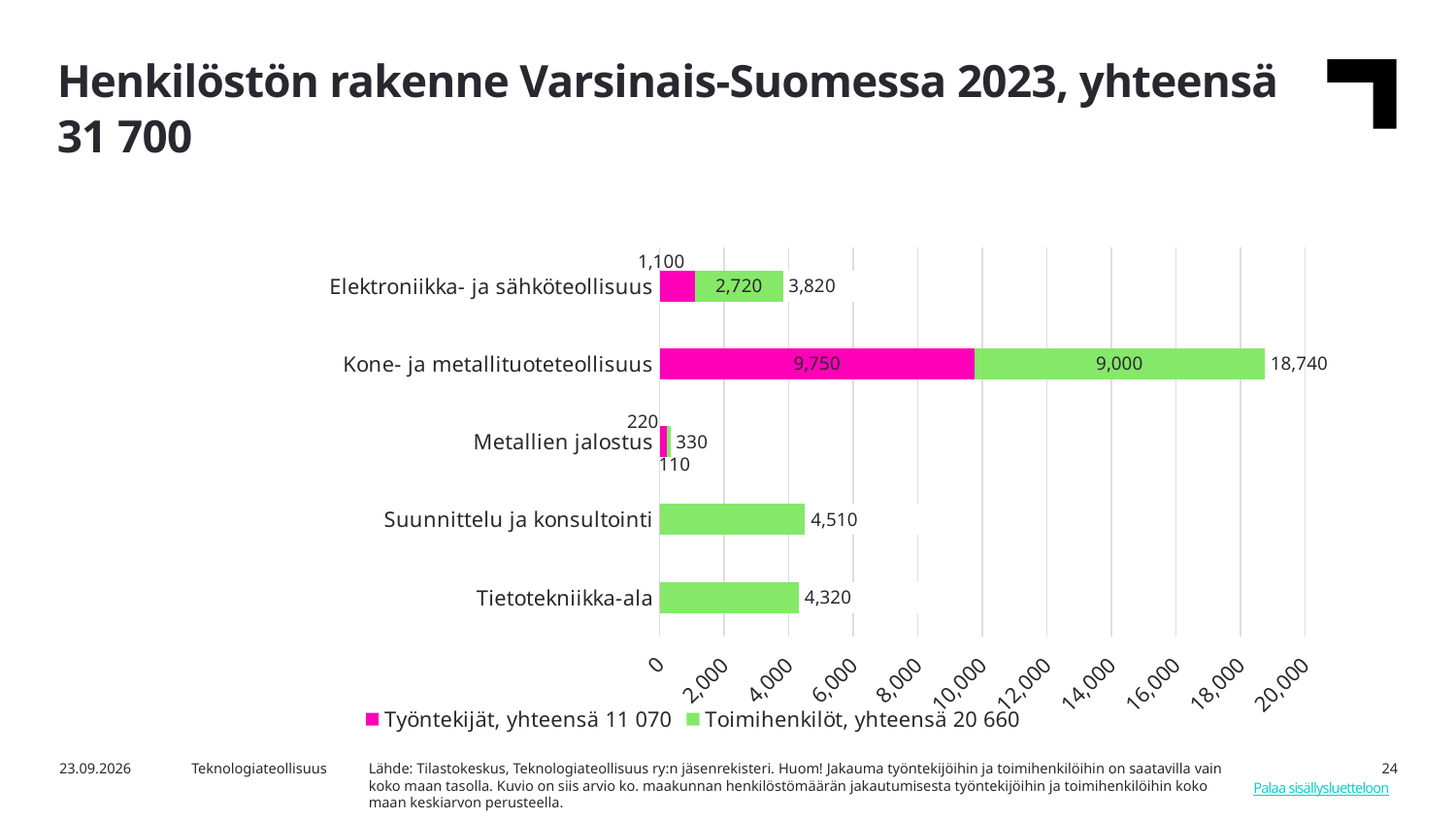
How many series does the legend list? 2 Which category has the lowest total value? Metallien jalostus What is the Toimihenkilöt value for Elektroniikka- ja sähköteollisuus? 2,720 Which is larger: the Työntekijät value for Kone- ja metallituoteteollisuus or its Toimihenkilöt value? Työntekijät (9,750) What type of chart is shown on the slide? bar chart What is the Työntekijät value for Kone- ja metallituoteteollisuus? 9,750 According to the legend, what is the total for Toimihenkilöt? 20 660 How many categories are shown on the chart? 5 What is the total of the stacked bar for Metallien jalostus? 330 Which category has the highest total value? Kone- ja metallituoteteollisuus What is the difference between the Toimihenkilöt values for Suunnittelu ja konsultointi and Tietotekniikka-ala? 190 What is the total of the stacked bar for Kone- ja metallituoteteollisuus? 18,740